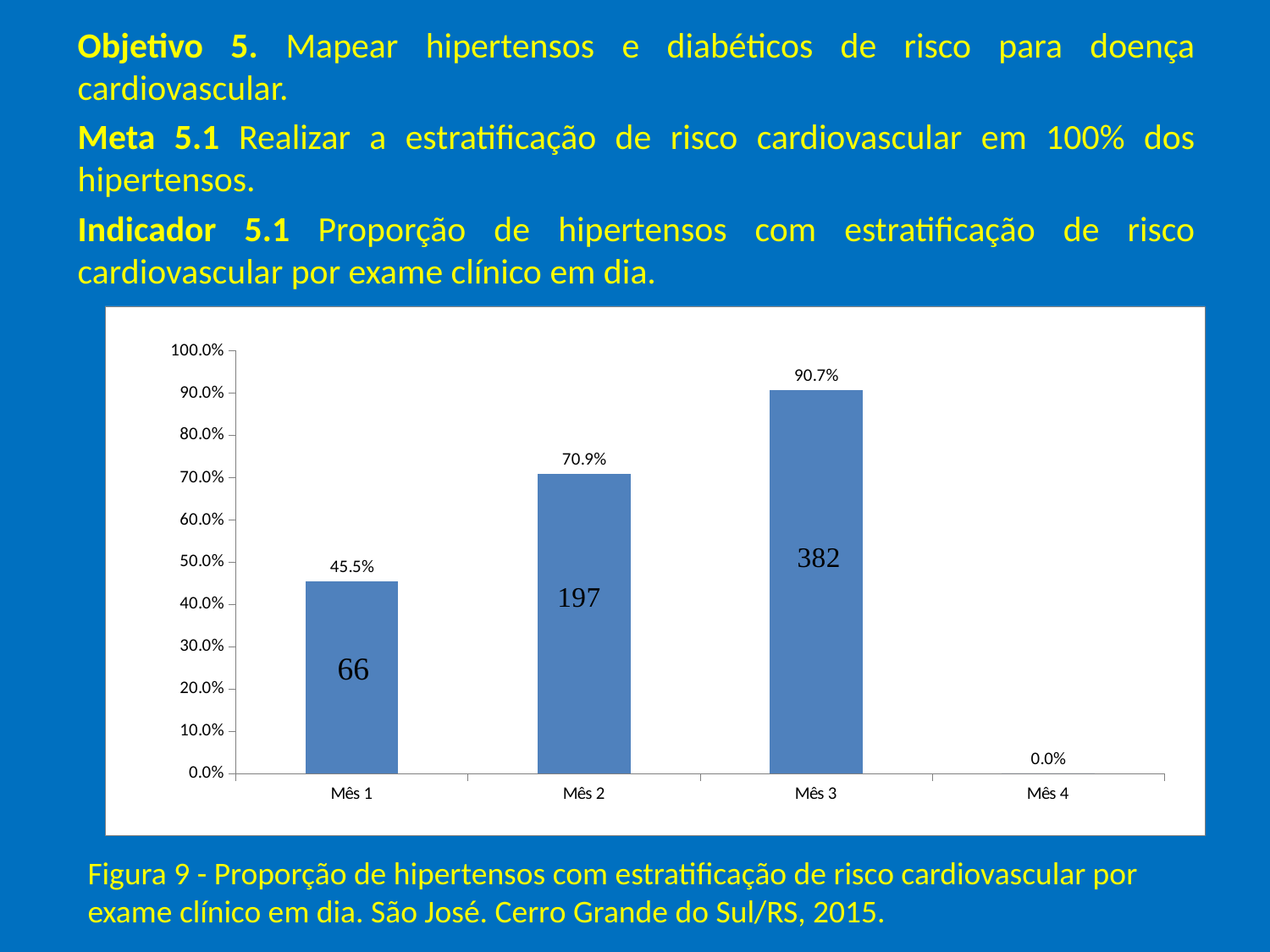
What is the value for Mês 1? 45.5% How many months are shown on the x axis? 4 Which month has the highest value? Mês 3 Which is larger, the value for Mês 1 or the value for Mês 2? Mês 2 What is the value for Mês 3? 90.7% What is the value for Mês 2? 70.9% Which month has the lowest value? Mês 4 Is the value for Mês 1 greater or less than 50.0%? less What kind of chart is shown? bar chart What is the value for Mês 4? 0.0% What number is printed inside the bar for Mês 2? 197 What is the difference between the values for Mês 3 and Mês 2? 19.8%